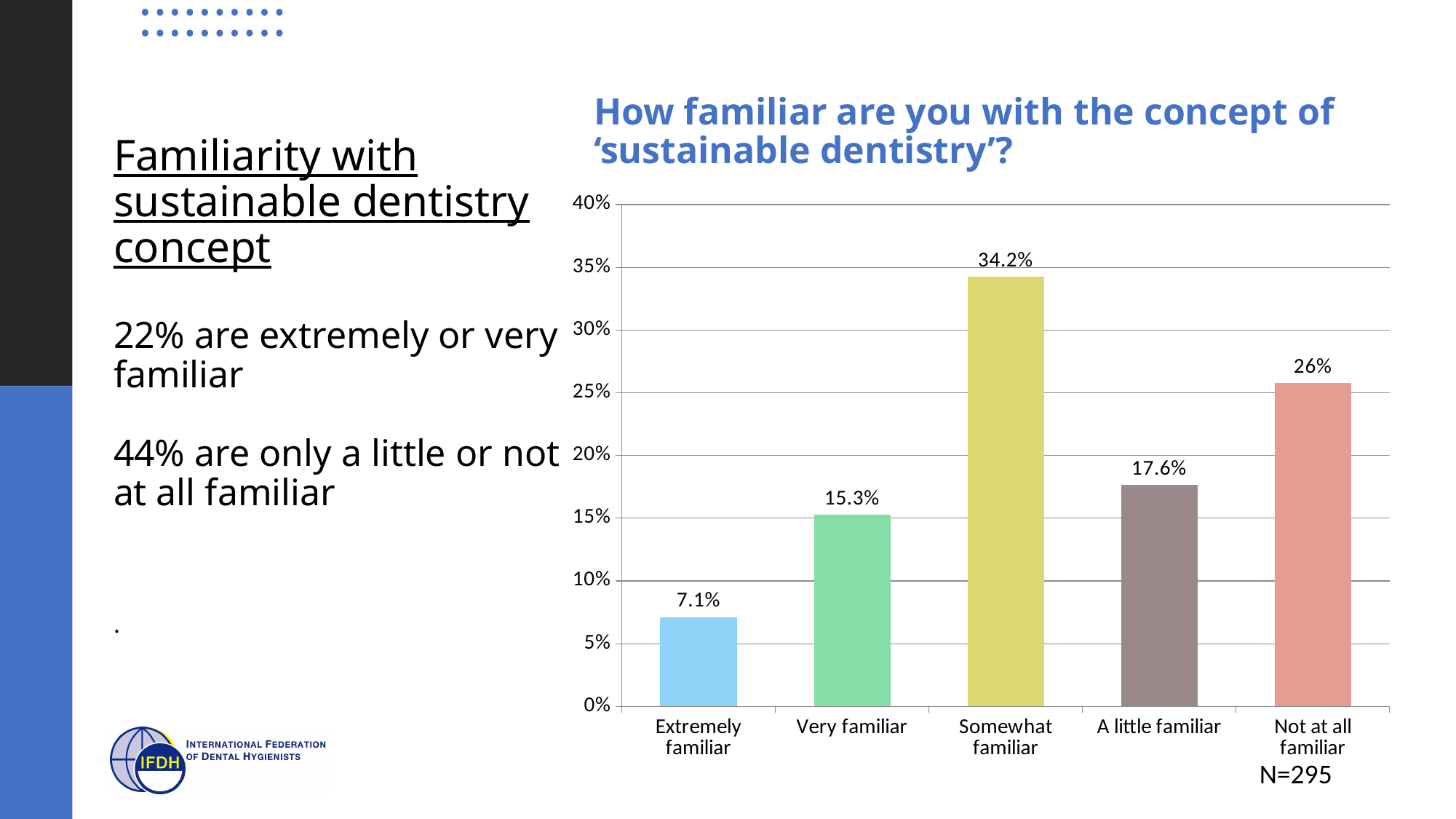
What is the difference between the 'A little familiar' and 'Very familiar' values? 2.3% What is the title of the chart? How familiar are you with the concept of 'sustainable dentistry'? What kind of chart is shown on the slide? Bar chart Which is larger, the value for 'Very familiar' or the value for 'A little familiar'? A little familiar How many categories are shown on the x axis of the chart? 5 Which category has the lowest value in the chart? Extremely familiar Is the value for 'Not at all familiar' greater or less than 25%? greater What percentage of respondents are 'Somewhat familiar' with the concept of sustainable dentistry? 34.2% What is the value shown for 'Not at all familiar'? 26% What is the value shown for 'Extremely familiar'? 7.1% Which category has the highest value in the chart? Somewhat familiar What is the difference between the 'Somewhat familiar' and 'Not at all familiar' values? 8.2%